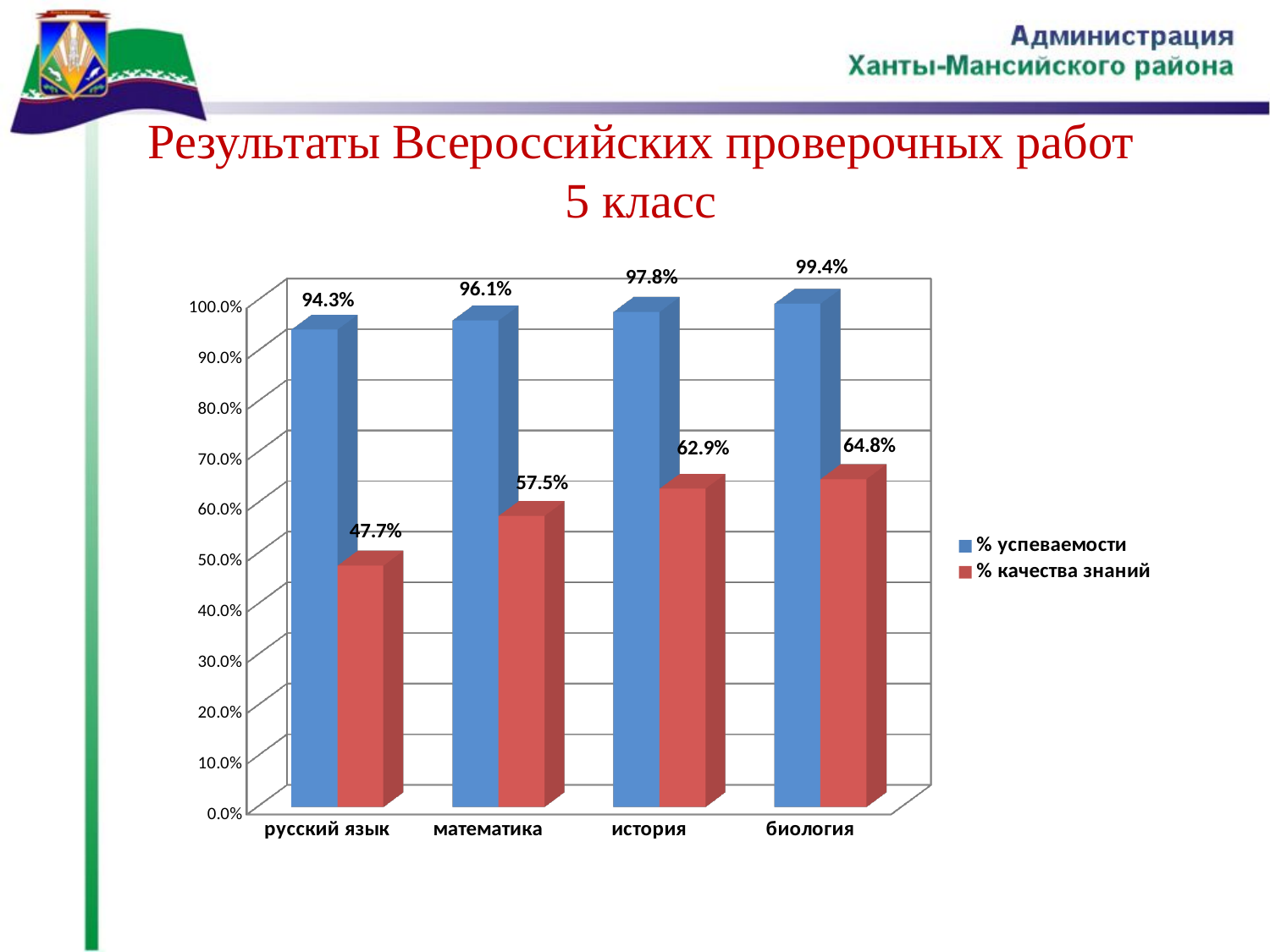
What is the difference between % успеваемости and % качества знаний for биология? 34.6% What is the % успеваемости value for математика? 96.1% Which subject has the highest % успеваемости? биология What is the % качества знаний value for история? 62.9% How many series does the legend list? 2 Which subject has the lowest % качества знаний? русский язык Is the % качества знаний value for русский язык greater or less than 50.0%? less Do the % успеваемости values rise or fall from русский язык to биология? rise How many subjects are shown on the x axis? 4 What is the % качества знаний value for русский язык? 47.7% What kind of chart is shown on the slide? bar chart Which is larger: % качества знаний for математика or for история? история